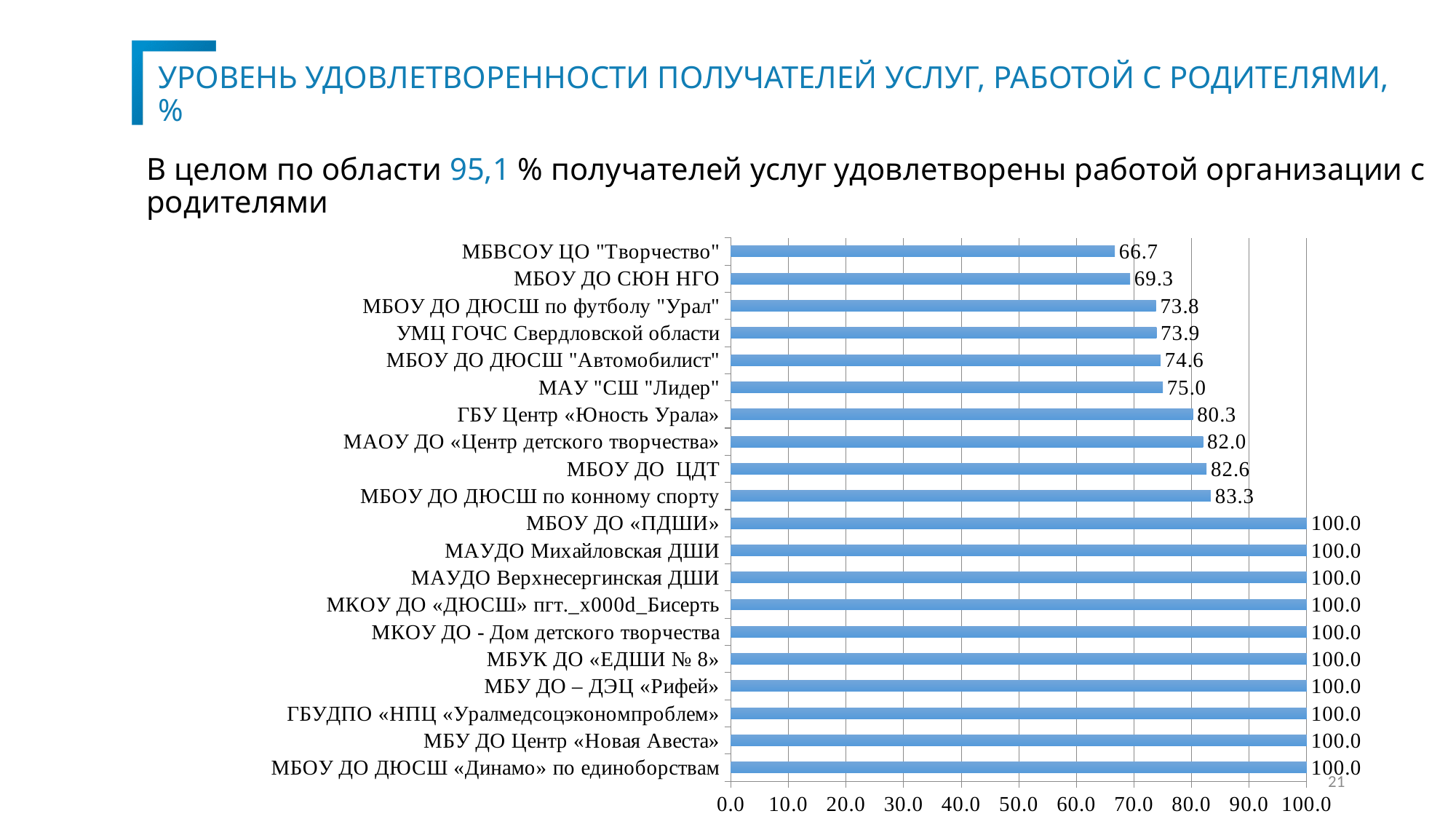
Which organisation has the lowest value? МБВСОУ ЦО "Творчество" Which is larger: the value for МАУ "СШ "Лидер" or the value for МБОУ ДО ДЮСШ "Автомобилист"? МАУ "СШ "Лидер" What is the value for ГБУ Центр «Юность Урала»? 80.3 What kind of chart is shown on the slide? bar chart What is the value for МАУДО Михайловская ДШИ? 100.0 What is the value for МБОУ ДО СЮН НГО? 69.3 What is the difference between the values for МБОУ ДО ЦДТ and МАОУ ДО «Центр детского творчества»? 0.6 According to the text on the slide, what percentage of service recipients across the region are satisfied with the organisation's work with parents? 95,1 % What is the value for МБВСОУ ЦО "Творчество"? 66.7 What is the value for МБОУ ДО ДЮСШ по конному спорту? 83.3 How many organisations are shown in the chart? 20 What is the difference between the values for МБОУ ДО «ПДШИ» and МБВСОУ ЦО "Творчество"? 33.3